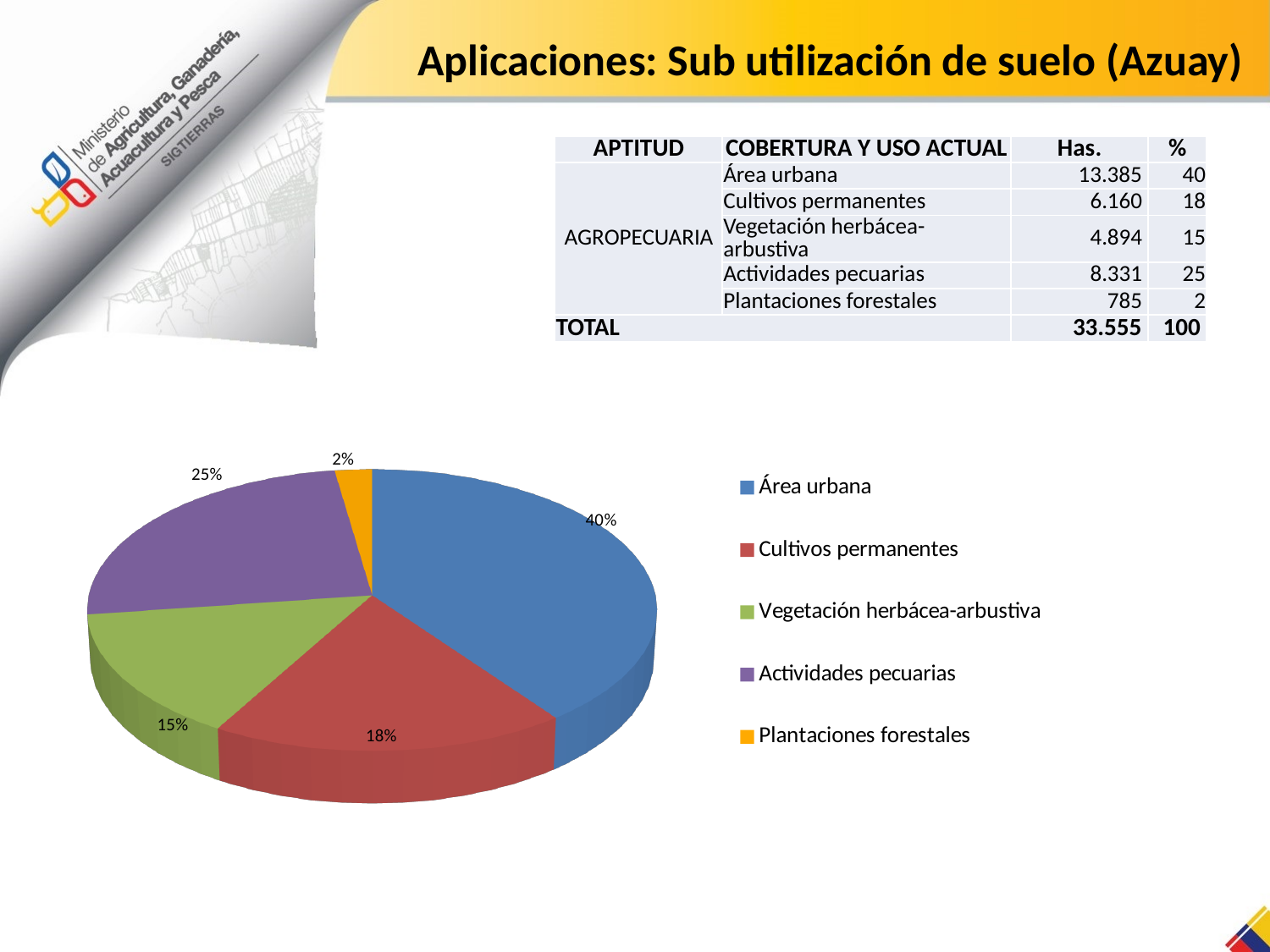
What share of the pie does Área urbana represent? 40% How many categories does the legend of the pie chart list? 5 What colour is the slice for Actividades pecuarias? Purple Which is larger, the slice for Cultivos permanentes or the slice for Vegetación herbácea-arbustiva? Cultivos permanentes Which category has the largest slice of the pie? Área urbana What share of the pie does Actividades pecuarias represent? 25% What share of the pie does Cultivos permanentes represent? 18% What kind of chart is shown on the slide? Pie chart Which category has the smallest slice of the pie? Plantaciones forestales What is the difference in percentage points between Área urbana and Actividades pecuarias? 15